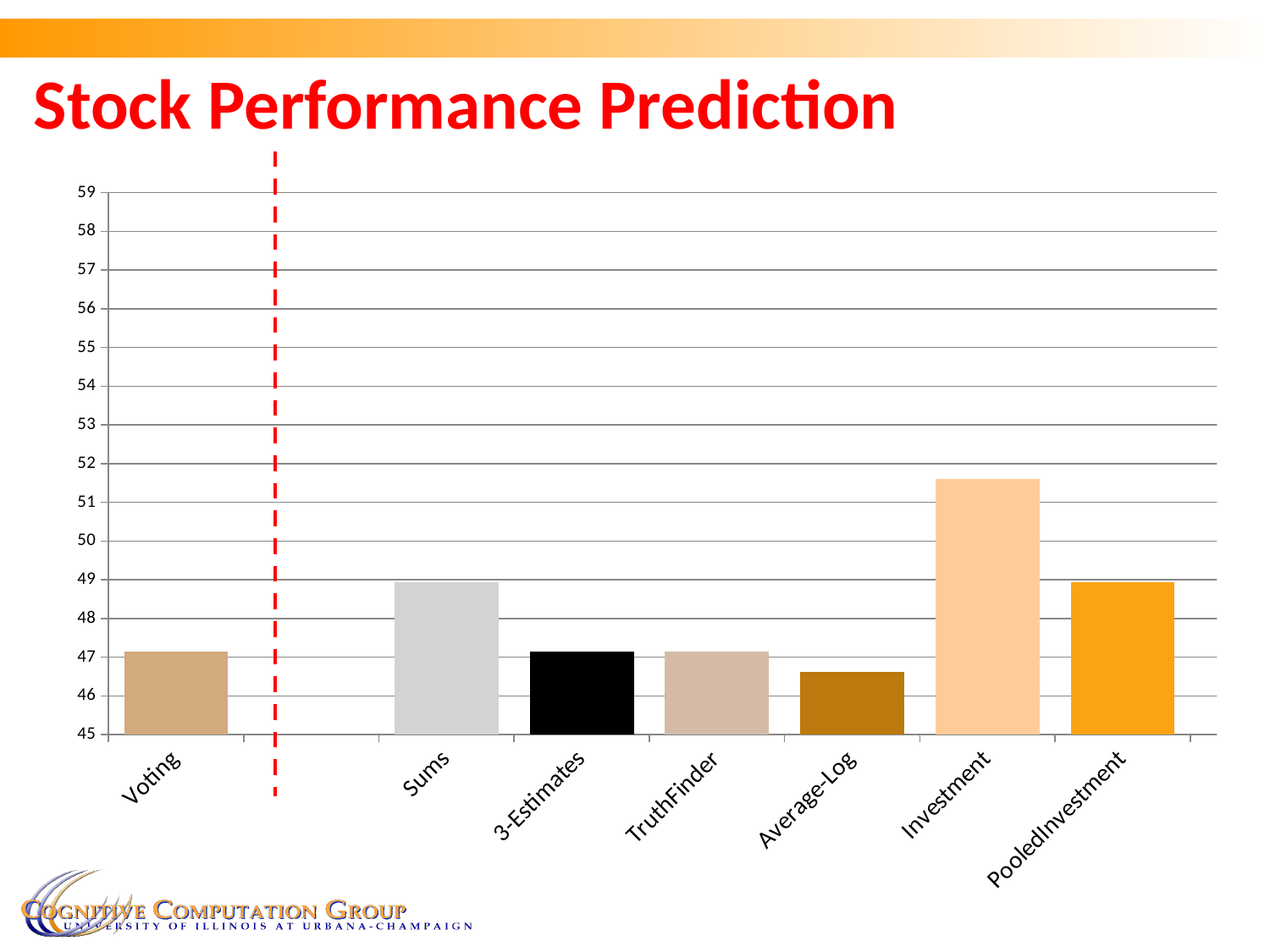
Is the value for Sums greater or less than 48? greater Is the value for Investment greater or less than 52? less Is the value for Average-Log greater or less than 47? less Which is larger, the value for Voting or the value for Average-Log? Voting Which category has the highest bar? Investment Which category is drawn with a black bar? 3-Estimates Which is larger, the value for Investment or the value for Sums? Investment What kind of chart is shown on the slide? bar chart How many categories are plotted on the x axis? 7 Which category has the lowest bar? Average-Log